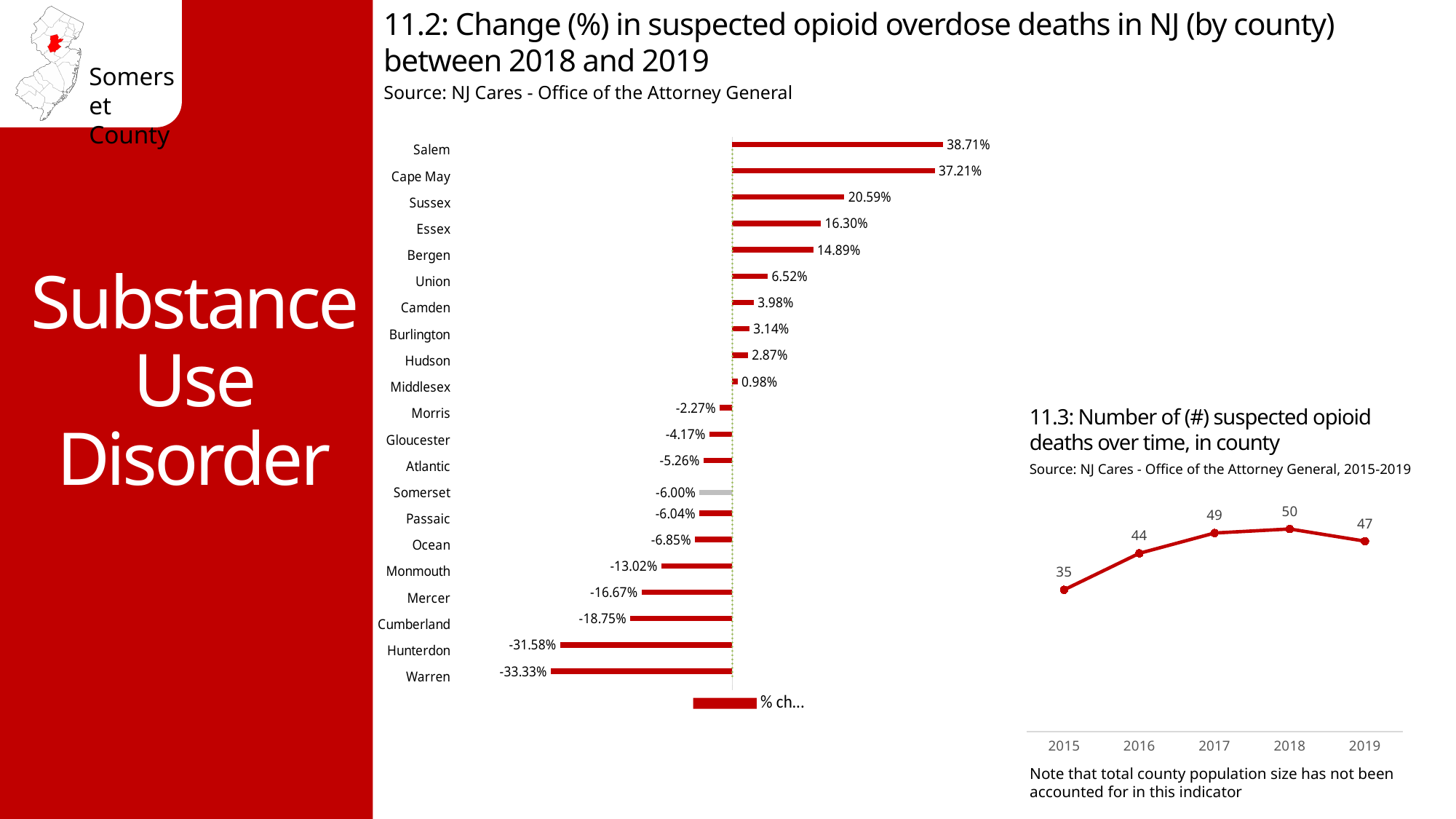
In chart 11.2 (change in suspected opioid overdose deaths by county), which is larger, the value for Sussex or the value for Essex? Sussex In chart 11.3 (number of suspected opioid deaths over time), which year has the lowest value? 2015 In chart 11.2 (change in suspected opioid overdose deaths by county), which county has the lowest percentage change? Warren In chart 11.2 (change in suspected opioid overdose deaths by county), what is the value for Somerset? -6.00% In chart 11.2 (change in suspected opioid overdose deaths by county), what is the difference between the values for Salem and Cape May? 1.50% What kind of chart is chart 11.3 (number of suspected opioid deaths over time)? Line chart In chart 11.2 (change in suspected opioid overdose deaths by county), what is the value for Bergen? 14.89% What kind of chart is chart 11.2 (change in suspected opioid overdose deaths by county)? Bar chart In chart 11.2 (change in suspected opioid overdose deaths by county), which county has the highest percentage change? Salem In chart 11.2 (change in suspected opioid overdose deaths by county), how many counties are shown? 21 In chart 11.3 (number of suspected opioid deaths over time), what is the difference between the values for 2019 and 2015? 12 In chart 11.3 (number of suspected opioid deaths over time), what is the value for 2018? 50